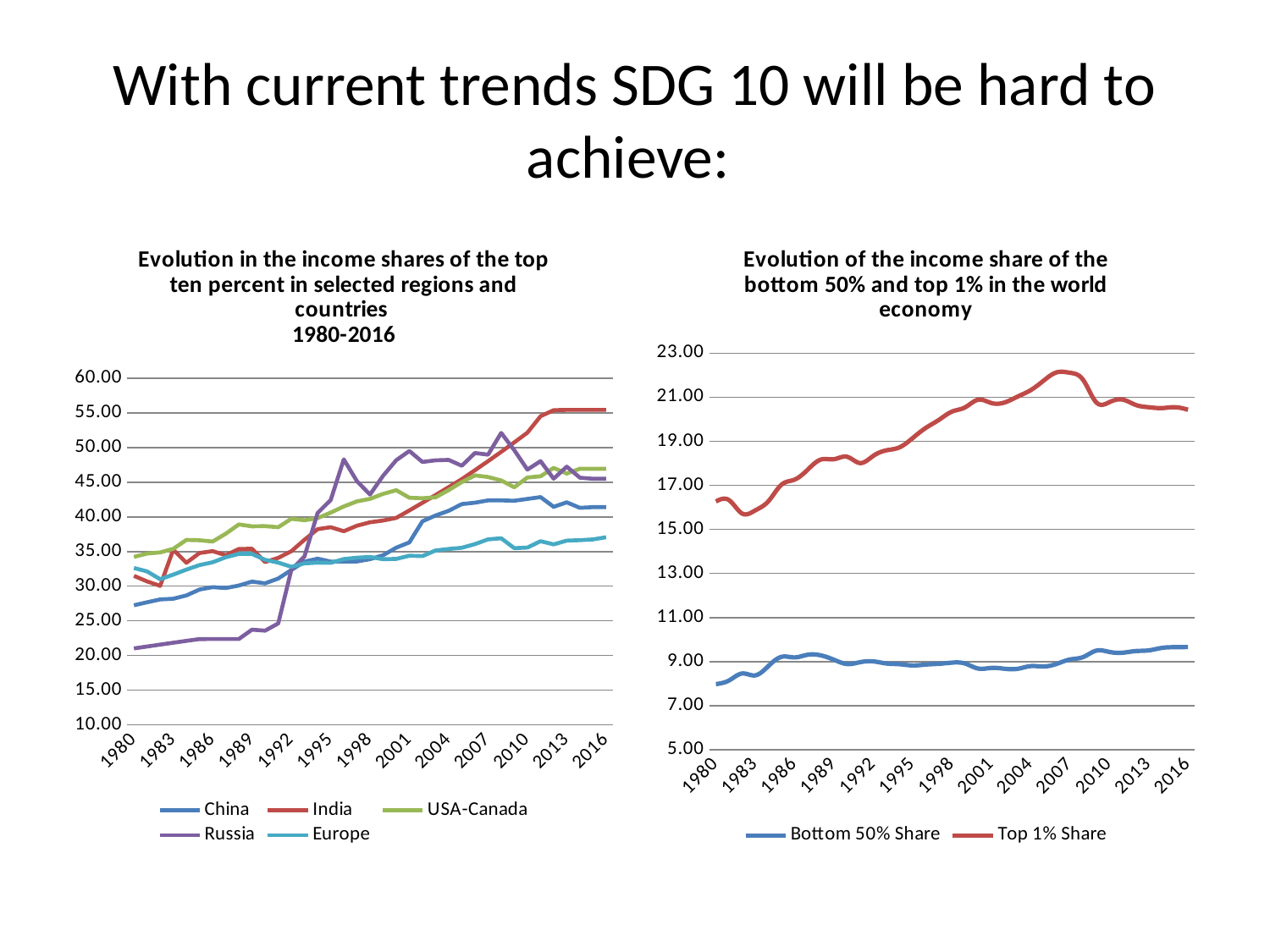
In the left chart (income shares of the top ten percent), is the value for India in 2016 greater or less than 50.00? greater In the left chart (income shares of the top ten percent), is the value for China in 1980 greater or less than 30.00? less In the right chart (bottom 50% and top 1% in the world economy), which series is higher in 2016, Bottom 50% Share or Top 1% Share? Top 1% Share How many series does the legend of the right chart (bottom 50% and top 1% in the world economy) list? 2 In the left chart (income shares of the top ten percent), does the China series rise or fall from 1980 to 2016? Rise In the right chart (bottom 50% and top 1% in the world economy), is the Top 1% Share in 2016 greater or less than 19.00? greater What is the title of the right chart? Evolution of the income share of the bottom 50% and top 1% in the world economy In the left chart (income shares of the top ten percent), which series has the lowest value in 1980? Russia What kind of chart is the left chart, 'Evolution in the income shares of the top ten percent in selected regions and countries 1980-2016'? Line chart How many series does the legend of the left chart (income shares of the top ten percent) list? 5 In the left chart (income shares of the top ten percent), which series has the highest value in 2016? India